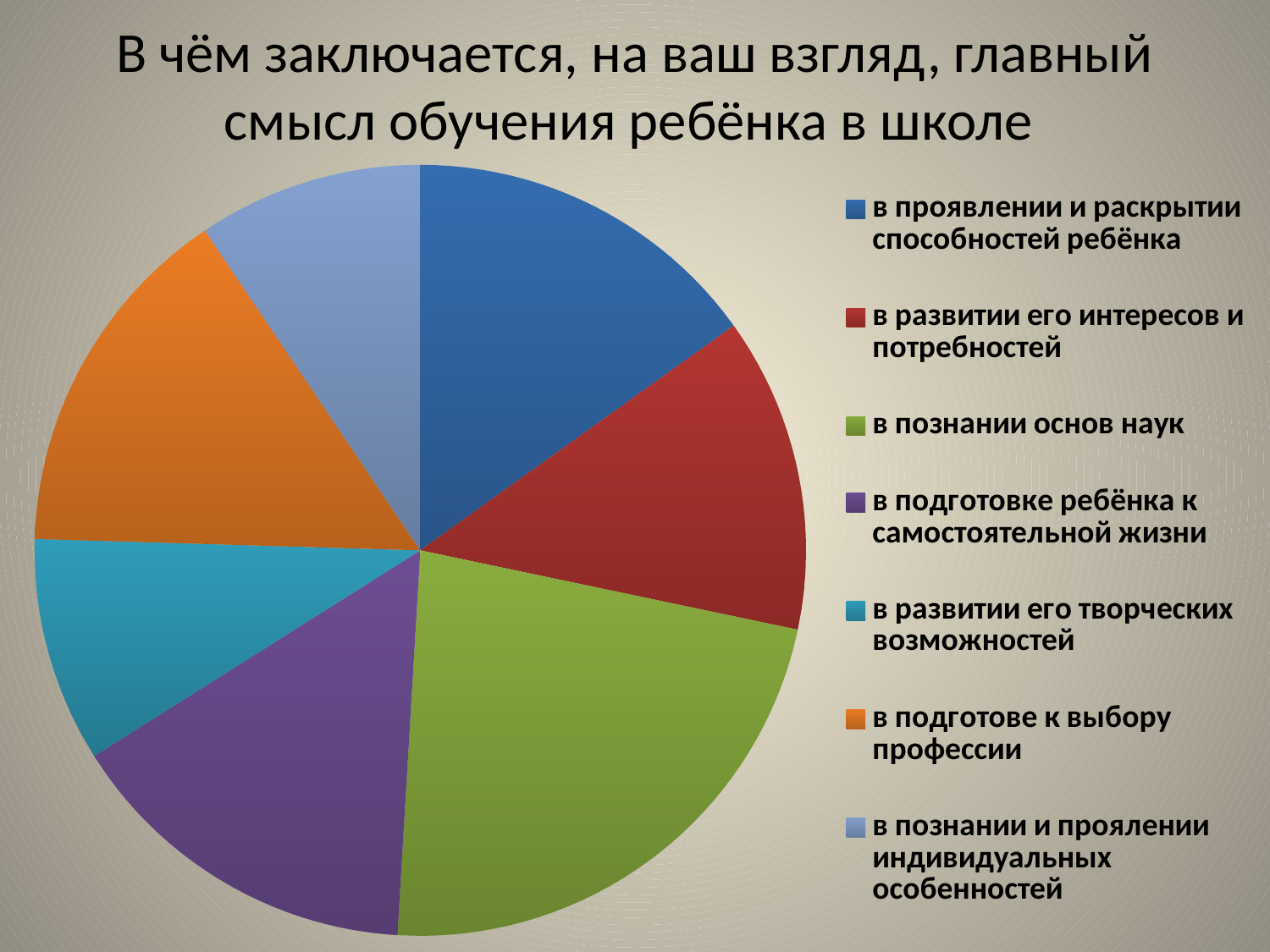
Which category has the largest slice of the pie? в познании основ наук Which slice is larger: "в развитии его интересов и потребностей" or "в познании и проялении индивидуальных особенностей"? в развитии его интересов и потребностей What kind of chart is shown on the slide? pie chart How many slices does the pie chart have? 7 What is the title of the chart? В чём заключается, на ваш взгляд, главный смысл обучения ребёнка в школе Which slice is larger: "в подготовке ребёнка к самостоятельной жизни" or "в развитии его творческих возможностей"? в подготовке ребёнка к самостоятельной жизни Which slice is larger: "в подготове к выбору профессии" or "в развитии его творческих возможностей"? в подготове к выбору профессии What colour is the slice for "в познании основ наук"? green How many entries does the legend list? 7